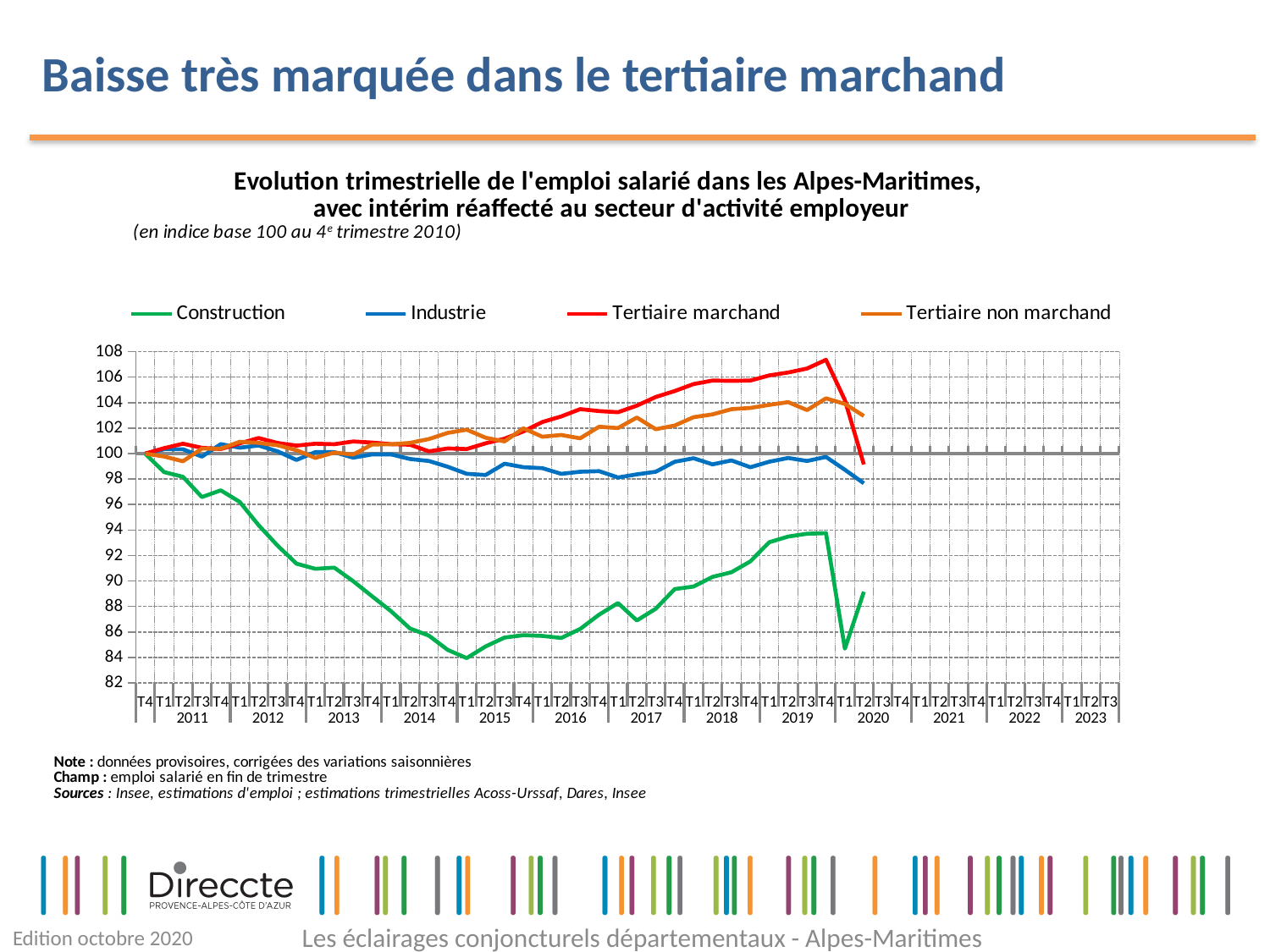
Does the Construction series rise or fall between T4 2010 and T1 2015? fall Is the value for Tertiaire marchand at T4 2019 greater or less than 106? greater At T1 2015, which is larger: the value for Construction or the value for Industrie? Industrie Which series has the highest value at T4 2019? Tertiaire marchand Which series has the lowest values across the whole period shown? Construction Is the value for Industrie at T2 2020 greater or less than 100? less What kind of chart is shown on the slide? line chart Which series is shown in green in the legend? Construction How many series does the legend list? 4 Is the value for Construction at T1 2015 greater or less than 86? less What is the index value of all series at T4 2010, the base quarter? 100